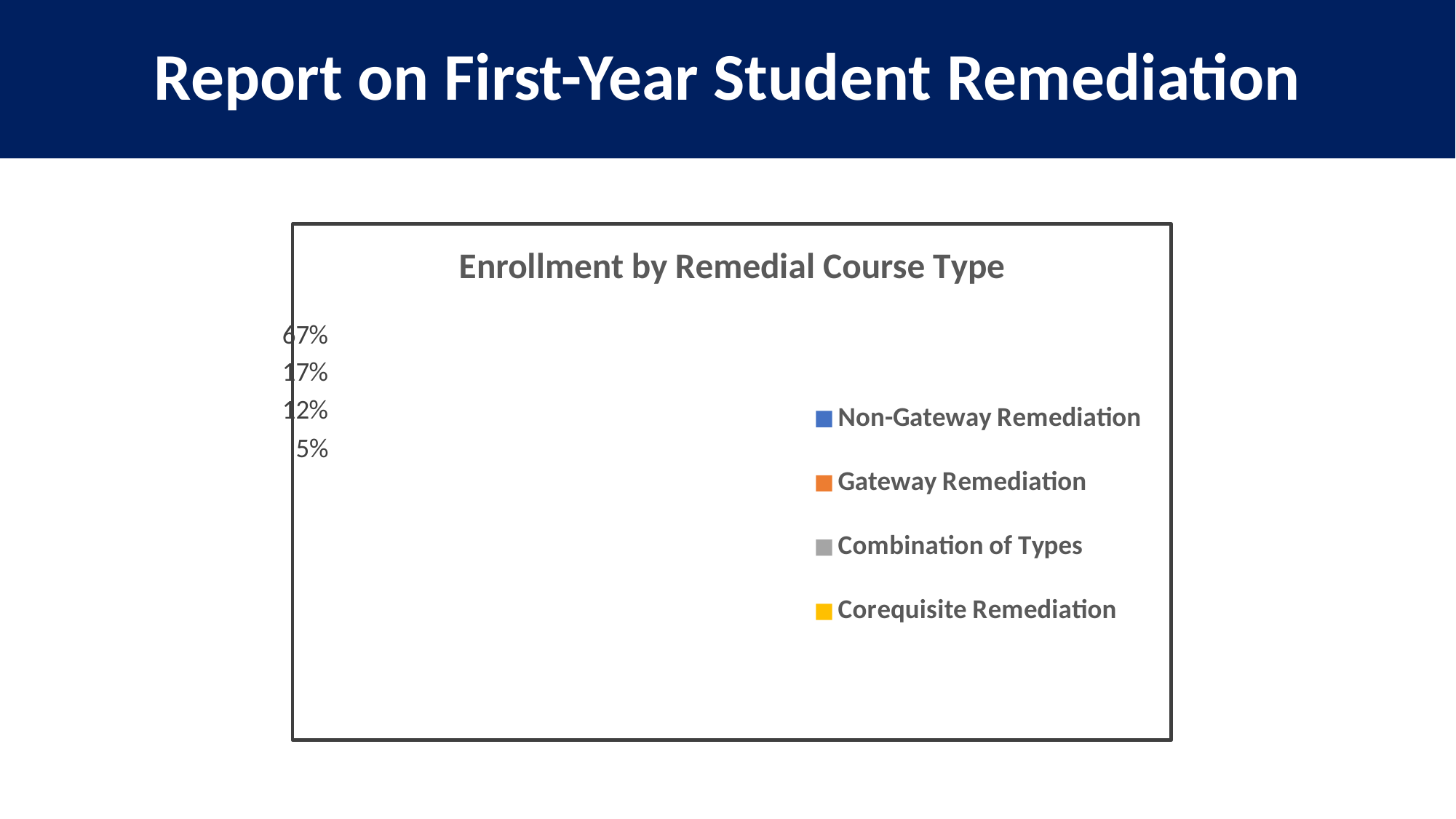
What is the title of the chart on the slide? Enrollment by Remedial Course Type Which is larger among the chart's data labels, 17% or 12%? 17% Which legend entry is shown with an orange marker? Gateway Remediation What is the largest percentage label shown on the chart? 67% What is the difference between the largest and smallest percentage labels shown on the chart? 62% How many percentage data labels are shown on the chart? 4 How many entries does the chart's legend list? 4 What is the smallest percentage label shown on the chart? 5%